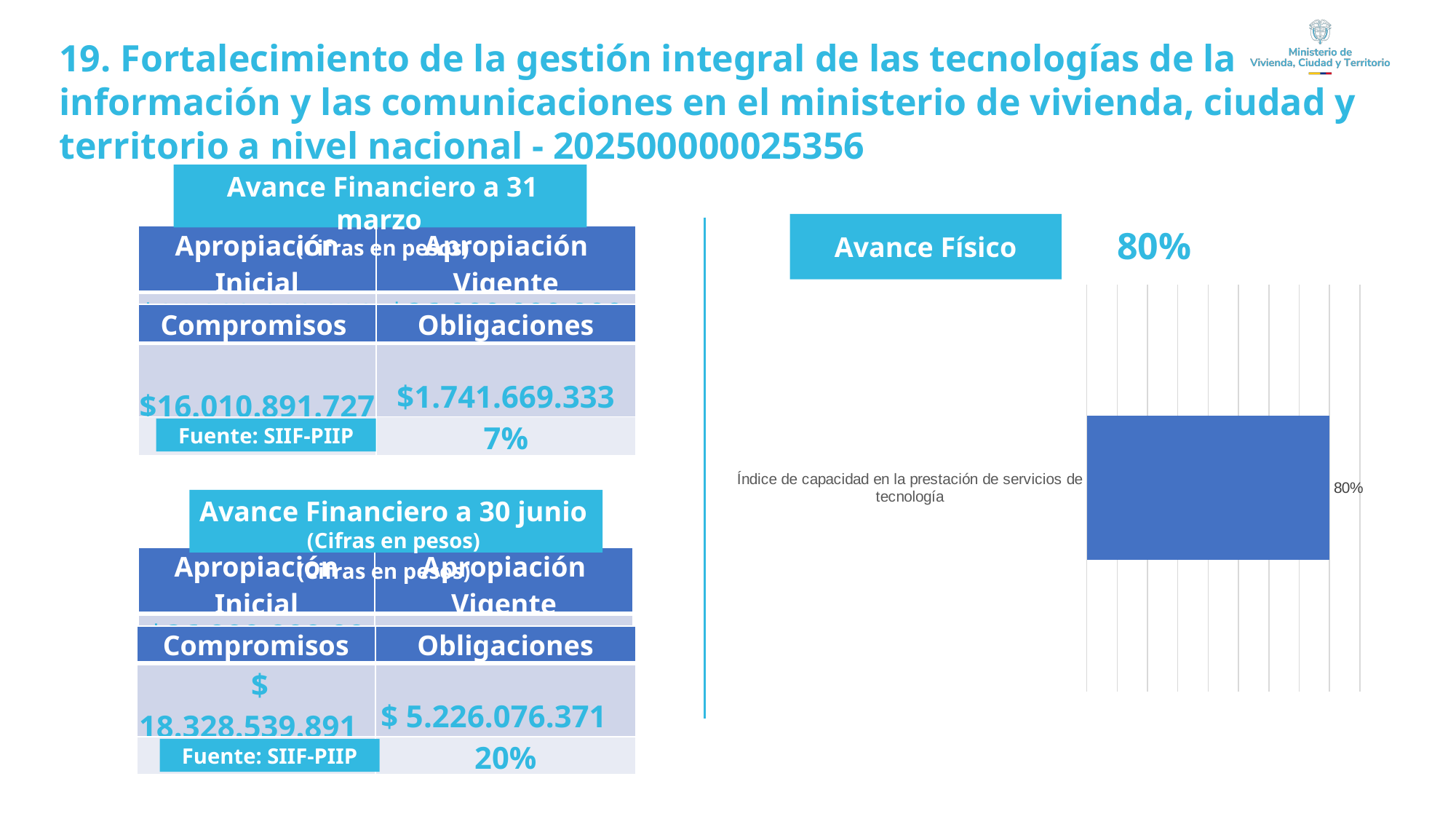
What heading appears above the bar chart on the right side of the slide? Avance Físico How many categories are plotted in the Avance Físico bar chart? 1 What is the label of the single category in the Avance Físico bar chart? Índice de capacidad en la prestación de servicios de tecnología What kind of chart is shown under the 'Avance Físico' heading? bar chart What is the value shown for 'Índice de capacidad en la prestación de servicios de tecnología' in the Avance Físico chart? 80% Are the bars in the Avance Físico chart drawn horizontally or vertically? horizontally